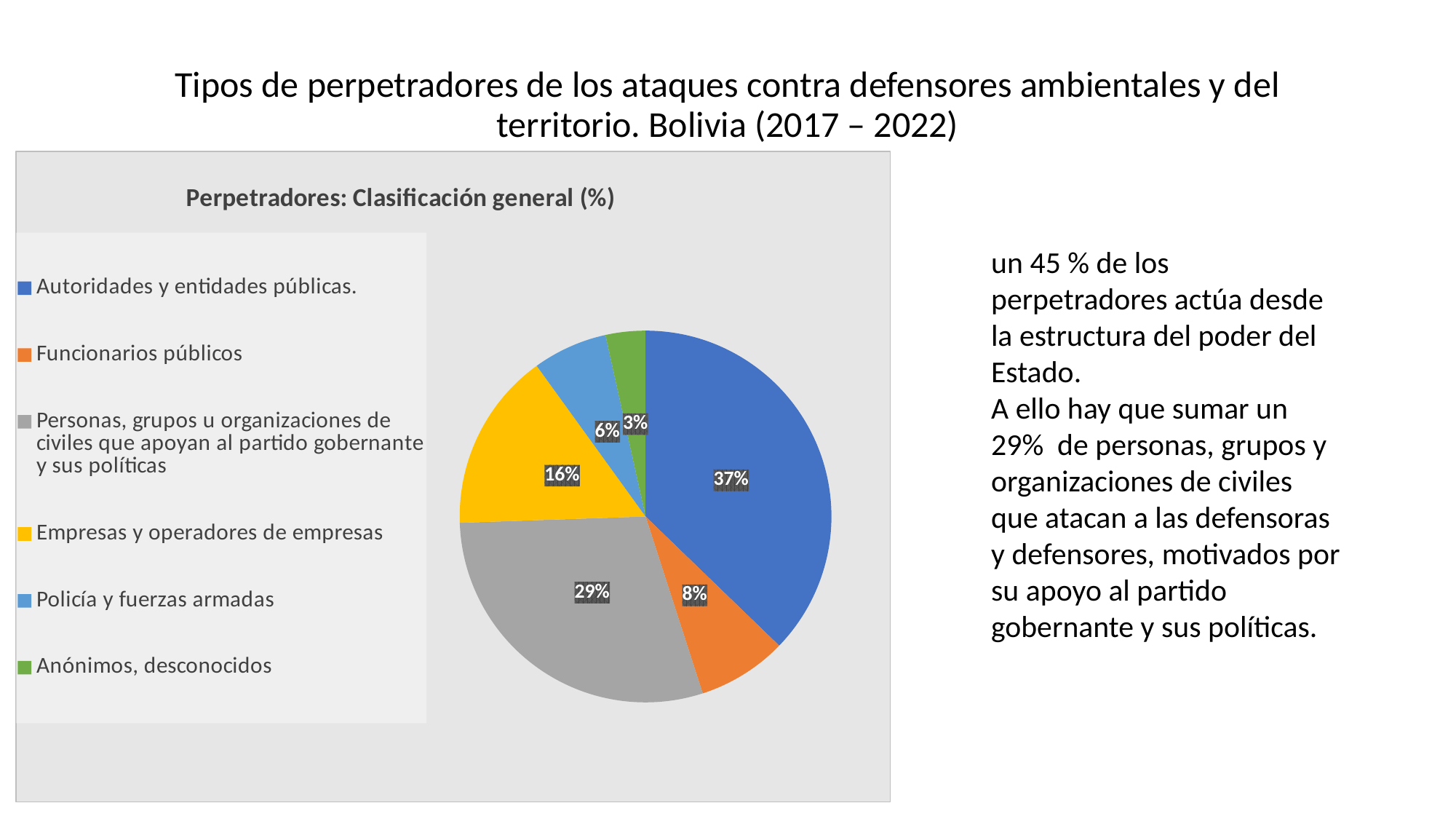
What is the difference in percentage points between 'Autoridades y entidades públicas.' and 'Empresas y operadores de empresas'? 21 What share of the pie is 'Funcionarios públicos'? 8% What share of the pie is 'Policía y fuerzas armadas'? 6% Which category has the smallest slice of the pie? Anónimos, desconocidos What share of the pie is 'Empresas y operadores de empresas'? 16% What kind of chart is shown on the slide? Pie chart Which category has the largest slice of the pie? Autoridades y entidades públicas. Which is larger: the slice for 'Funcionarios públicos' or the slice for 'Policía y fuerzas armadas'? Funcionarios públicos How many categories does the pie chart have? 6 What is the chart's title? Perpetradores: Clasificación general (%)